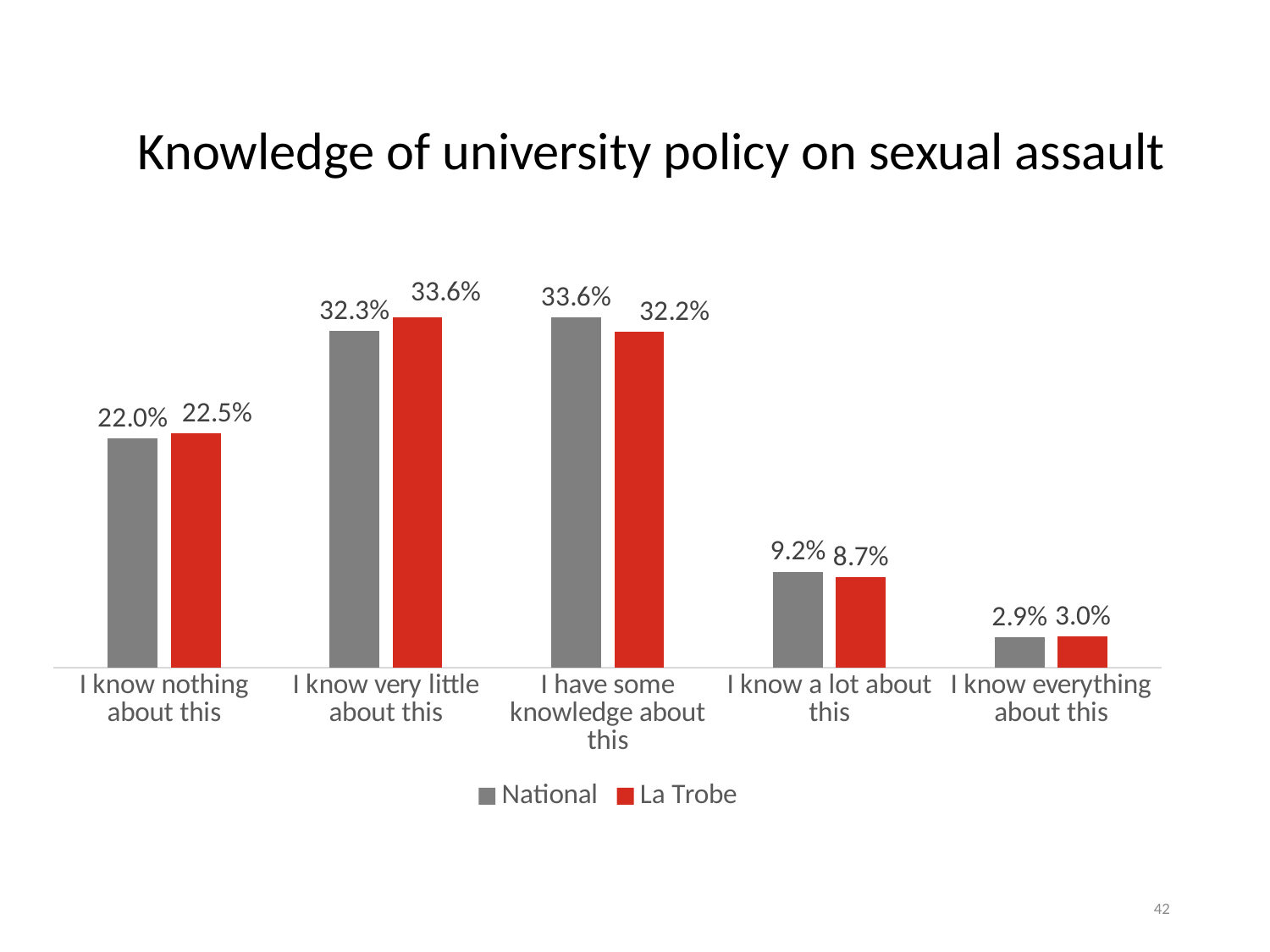
How many categories are shown on the x axis? 5 What is the title of the chart? Knowledge of university policy on sexual assault What is the National value for "I know nothing about this"? 22.0% For "I know a lot about this", which is larger: the National value or the La Trobe value? National What is the La Trobe value for "I know very little about this"? 33.6% What is the La Trobe value for "I know a lot about this"? 8.7% How many series does the legend list? 2 Which category has the lowest La Trobe value? I know everything about this Which category has the highest National value? I have some knowledge about this What is the difference between the National and La Trobe values for "I have some knowledge about this"? 1.4% What kind of chart is shown on the slide? Bar chart What is the National value for "I have some knowledge about this"? 33.6%